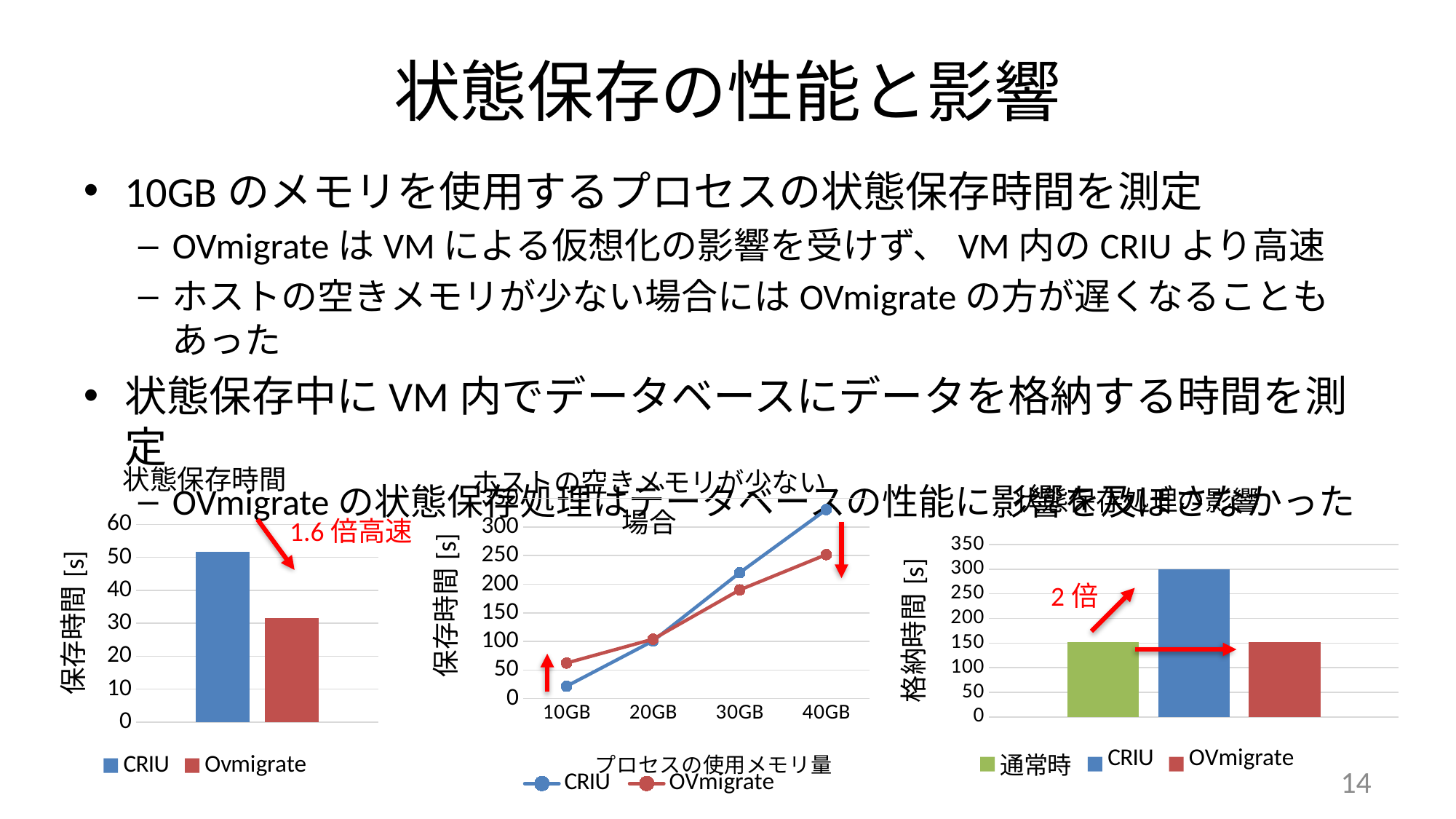
In the left chart titled 状態保存時間, what kind of chart is it? bar chart In the middle line chart, which series has the higher value at 40GB, CRIU or OVmigrate? CRIU In the left chart titled 状態保存時間, is the value for Ovmigrate greater or less than 40? less In the middle line chart, is the CRIU value at 40GB greater or less than 300? greater In the middle line chart, how many points are plotted along the x axis for each series? 4 In the middle line chart, does the CRIU line rise or fall as the process memory increases from 10GB to 40GB? rise In the right bar chart, which category has the highest bar? CRIU In the middle line chart, is the CRIU value at 10GB greater or less than 50? less In the middle line chart, how many series does the legend list? 2 In the left chart titled 状態保存時間, which series has the taller bar, CRIU or Ovmigrate? CRIU